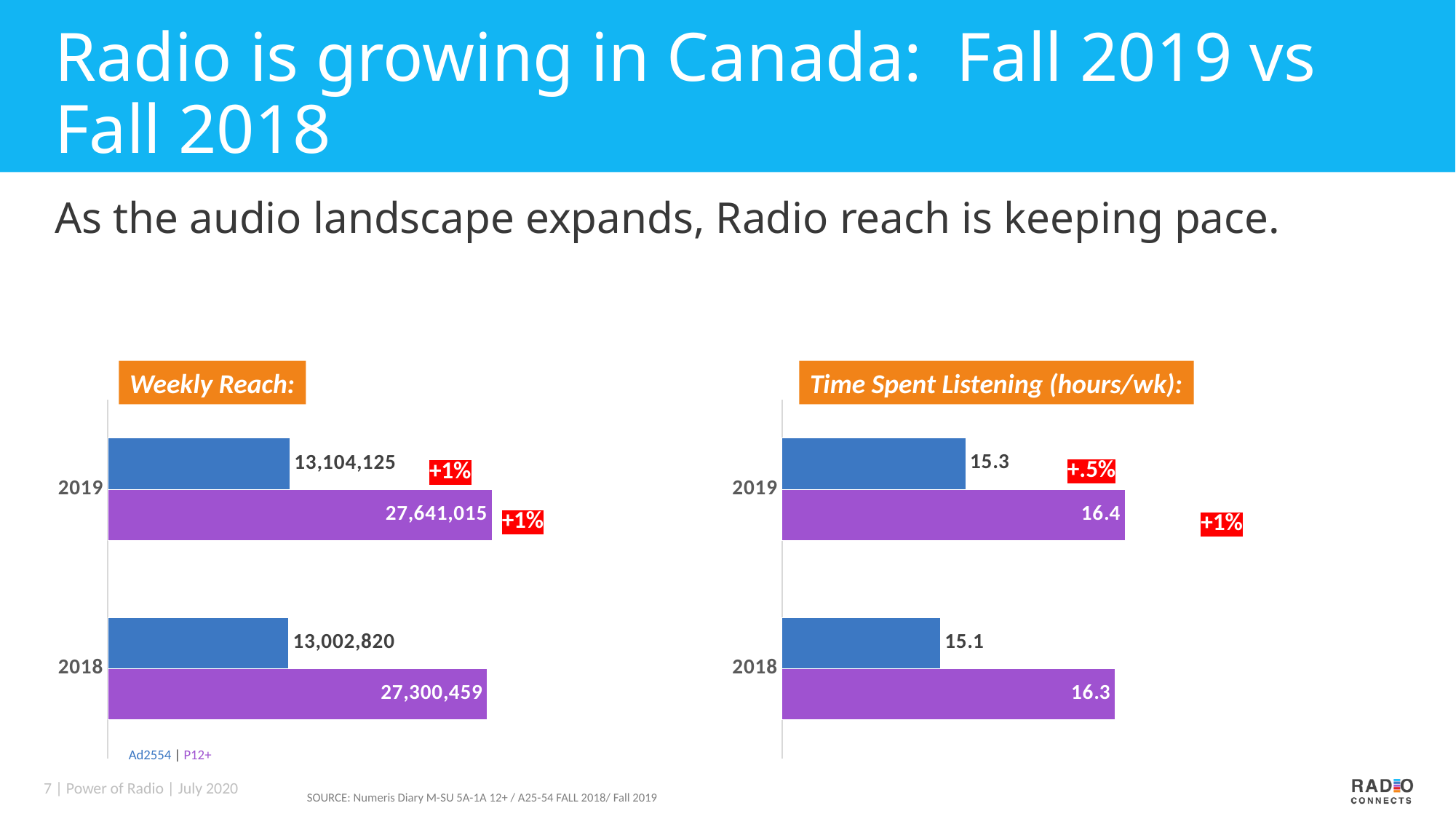
In the Weekly Reach chart, what percentage change label is shown next to the 2019 P12+ bar? +1% In the Weekly Reach chart, what is the Ad2554 value for 2018? 13,002,820 What kind of chart is the Weekly Reach chart? Bar chart In the Weekly Reach chart, which is larger for 2019: the Ad2554 value or the P12+ value? P12+ How many series does the legend under the Weekly Reach chart list? 2 In the Time Spent Listening (hours/wk) chart, what is the Ad2554 value for 2019? 15.3 In the Weekly Reach chart, what is the P12+ value for 2019? 27,641,015 In the Time Spent Listening (hours/wk) chart, what is the difference between the P12+ values for 2019 and 2018? 0.1 How many years are shown in the Time Spent Listening (hours/wk) chart? 2 In the Time Spent Listening (hours/wk) chart, what is the P12+ value for 2018? 16.3 In the Time Spent Listening (hours/wk) chart, which year has the higher Ad2554 value? 2019 In the Weekly Reach chart, what is the difference between the Ad2554 values for 2019 and 2018? 101,305